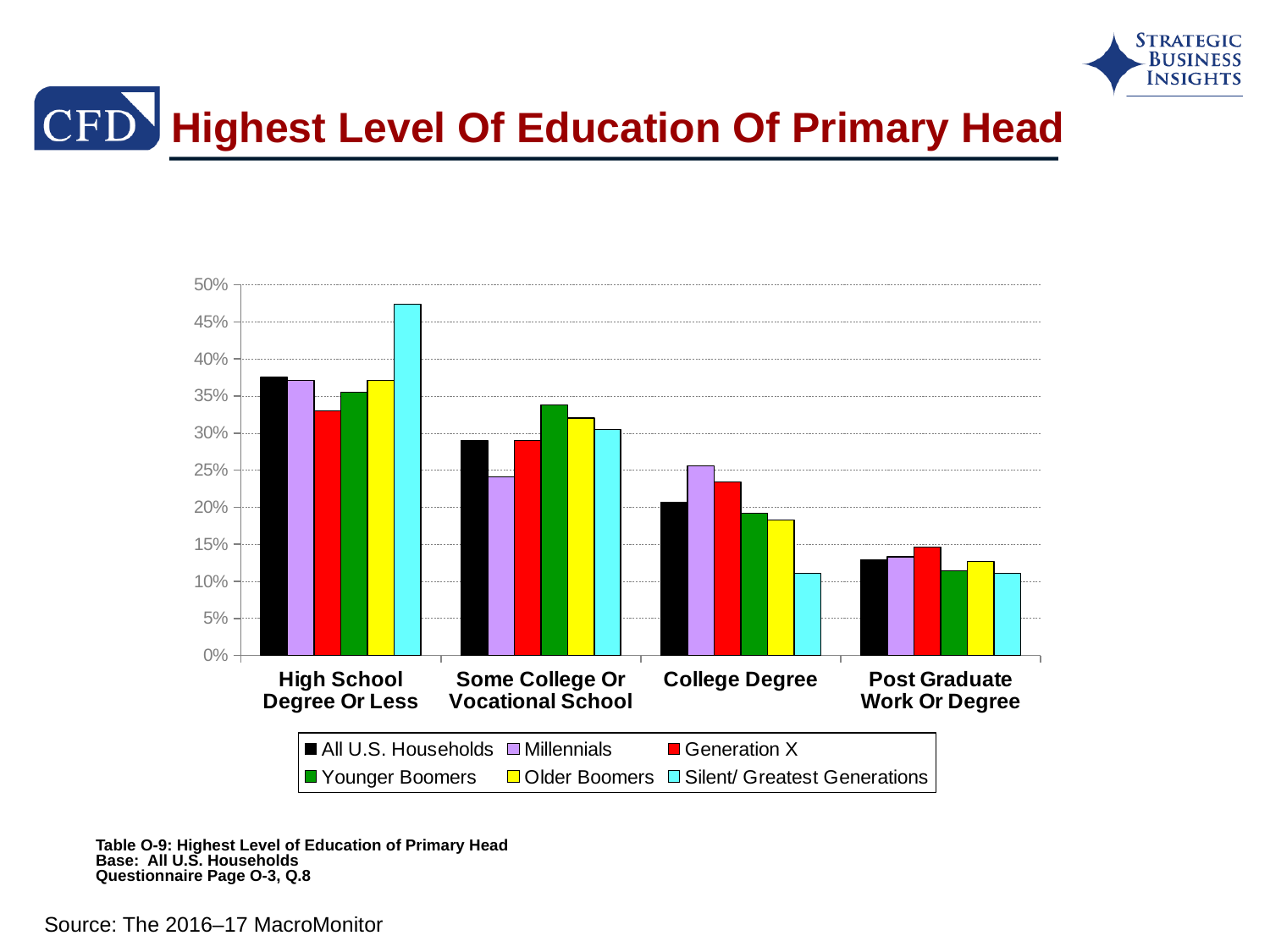
In the High School Degree Or Less category, which series has the highest value? Silent/ Greatest Generations In the College Degree category, which series has the lowest value? Silent/ Greatest Generations How many series does the legend list? 6 How many education categories are shown on the x axis? 4 Is the value for Younger Boomers in the Post Graduate Work Or Degree category greater or less than 15%? less What colour are the Generation X bars? red Is the value for Silent/ Greatest Generations in the High School Degree Or Less category greater or less than 45%? greater For the Silent/ Greatest Generations series, do the values rise or fall moving from High School Degree Or Less to Post Graduate Work Or Degree? fall Is the value for Millennials in the Some College Or Vocational School category greater or less than 25%? less What kind of chart is shown on the slide? bar chart In the Some College Or Vocational School category, which series has the highest value? Younger Boomers In the College Degree category, which is larger: Millennials or Silent/ Greatest Generations? Millennials